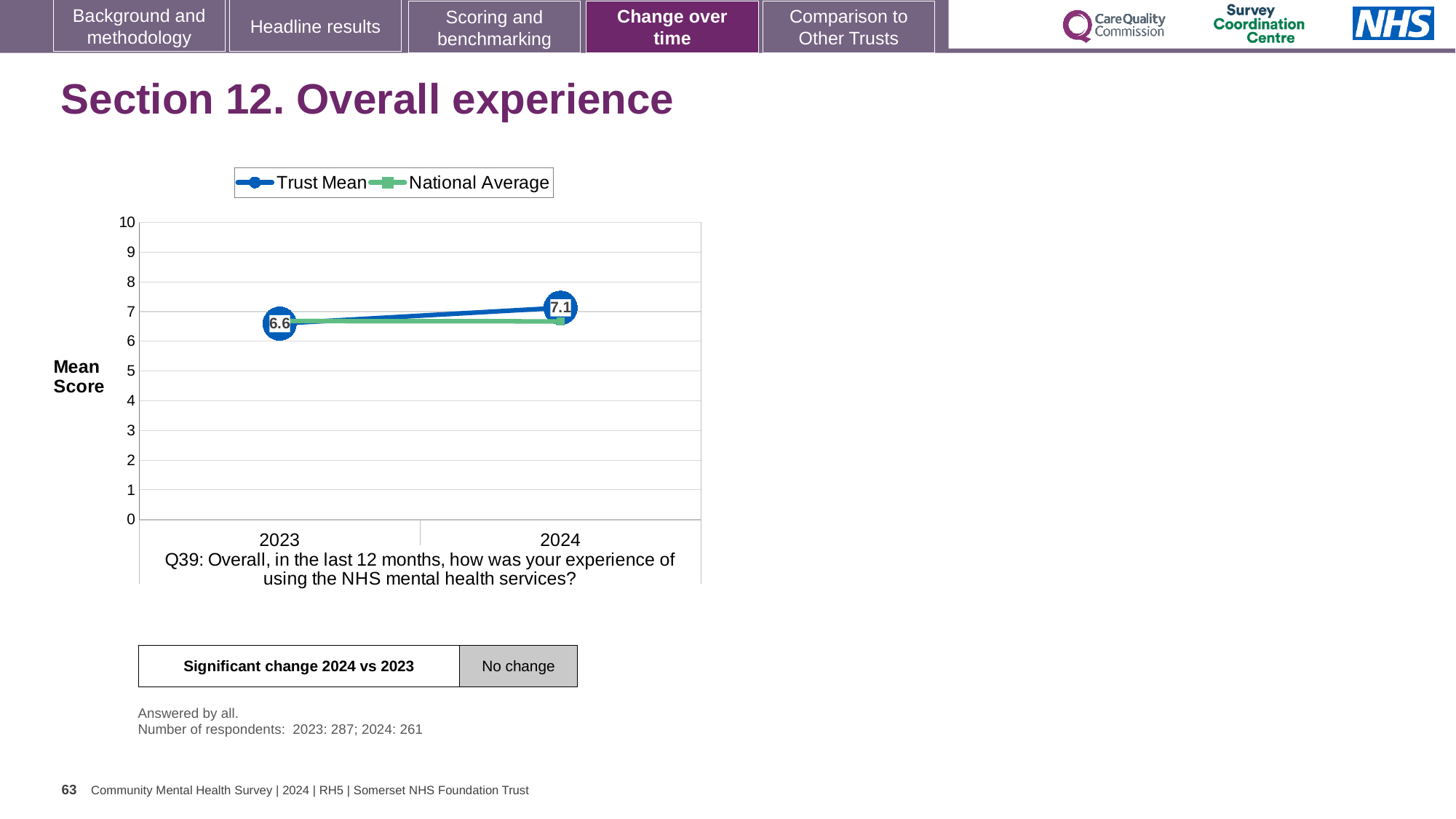
How many series does the legend list? 2 How many years are plotted on the x axis? 2 Is the National Average value for 2023 greater or less than 5? greater Which year has the higher Trust Mean, 2023 or 2024? 2024 By how much did the Trust Mean change from 2023 to 2024? 0.5 Is the National Average value for 2024 greater or less than 8? less What is the Trust Mean value for 2023? 6.6 What is the Trust Mean value for 2024? 7.1 What is the label on the y axis of the chart? Mean Score What kind of chart is shown? line chart Does the Trust Mean rise or fall from 2023 to 2024? rise In 2024, which series has the higher value, Trust Mean or National Average? Trust Mean